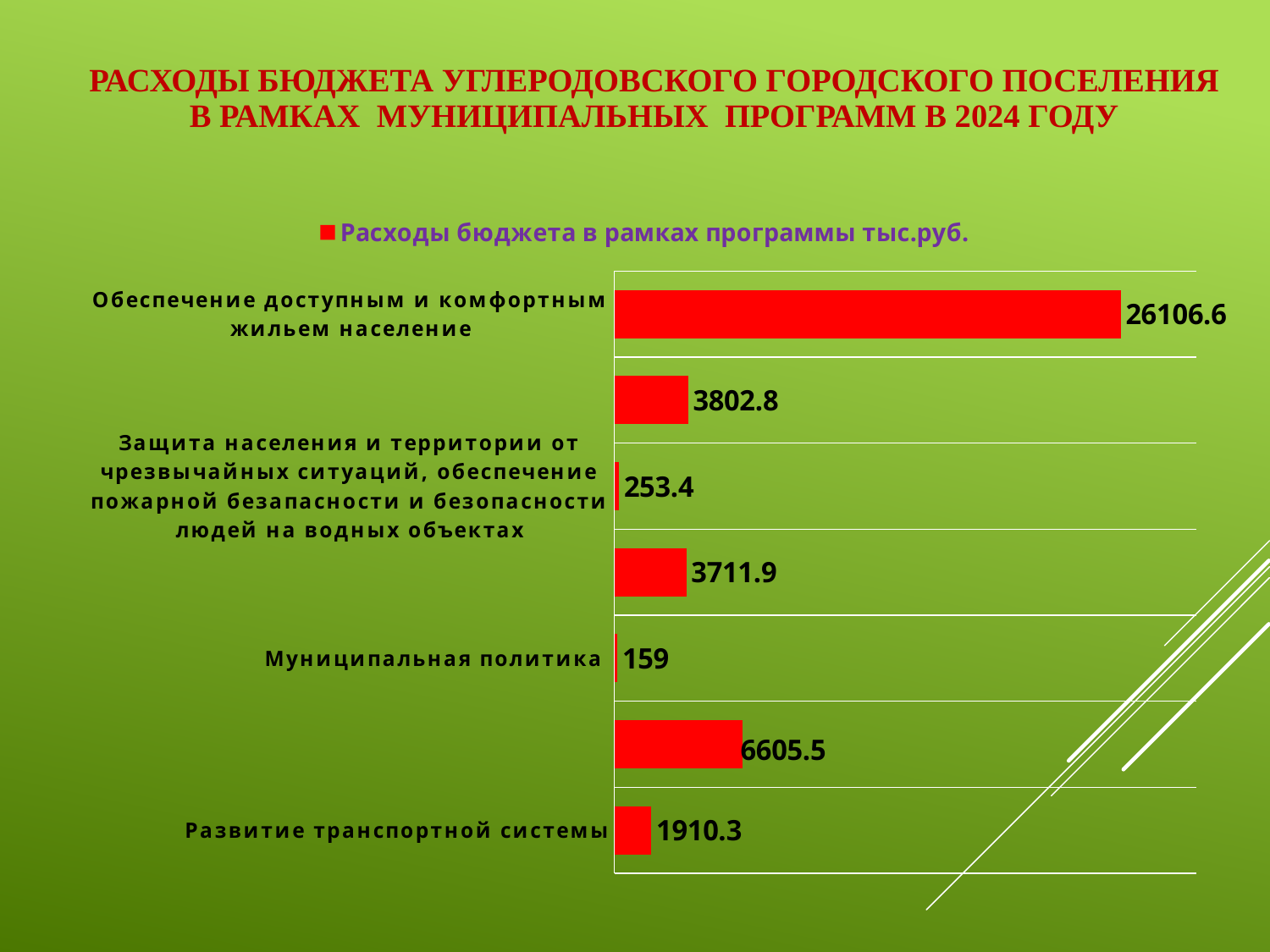
Which category has the lowest value? Муниципальная политика What kind of chart is shown on the slide? Bar chart How many series does the legend list? 1 Which is larger: the value for «Развитие транспортной системы» or for «Муниципальная политика»? Развитие транспортной системы Which category has the highest value? Обеспечение доступным и комфортным жильем население How many bars are plotted in the chart? 7 What is the value for «Муниципальная политика»? 159 What is the value for «Развитие транспортной системы»? 1910.3 What is the value for «Обеспечение доступным и комфортным жильем население»? 26106.6 What is the difference between the values for «Развитие транспортной системы» and «Муниципальная политика»? 1751.3 What is the value for «Защита населения и территории от чрезвычайных ситуаций, обеспечение пожарной безапасности и безопасности людей на водных объектах»? 253.4 What is the legend entry of the chart? Расходы бюджета в рамках программы тыс.руб.